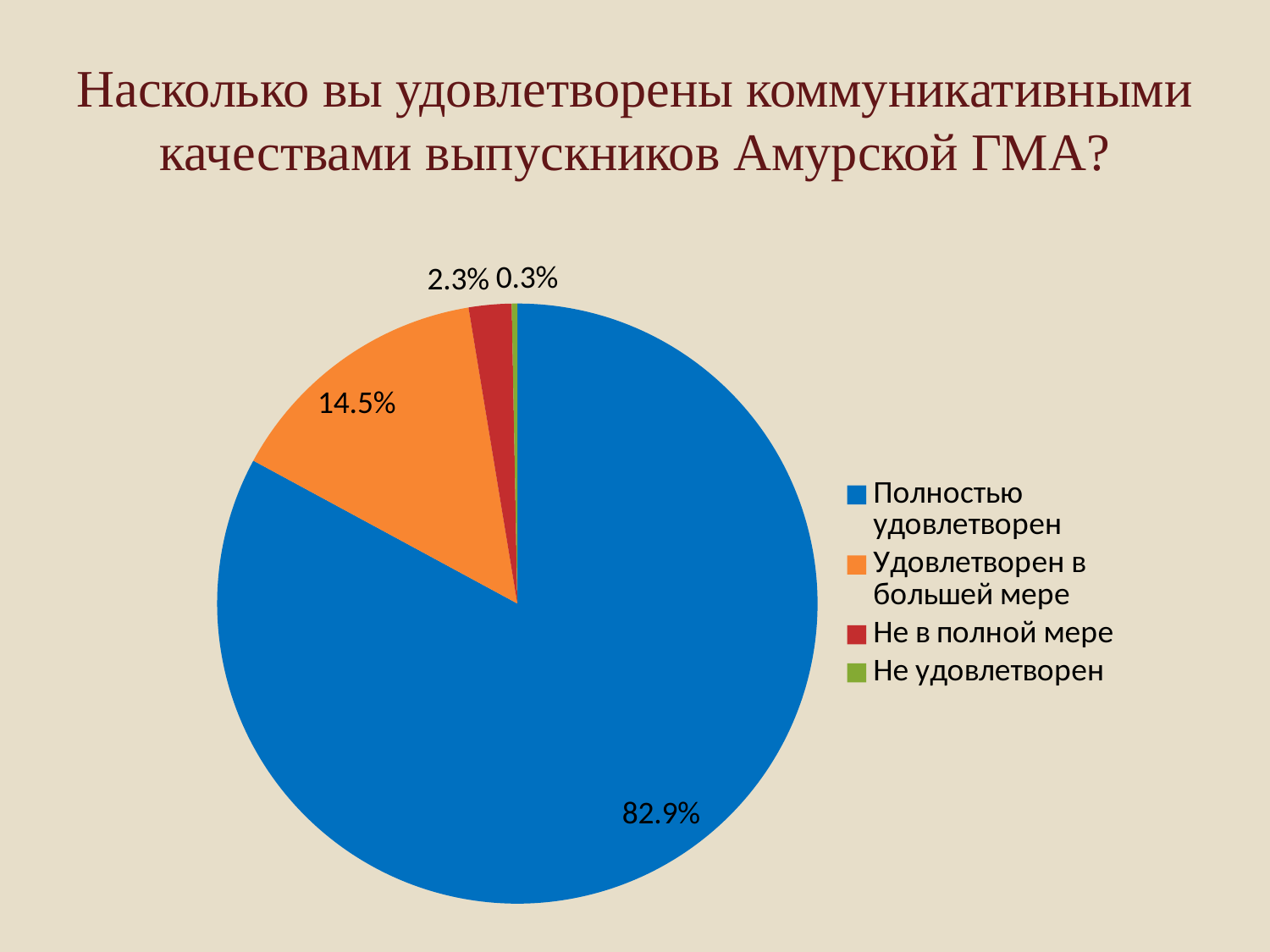
What colour is the slice for "Удовлетворен в большей мере"? Orange What share of respondents answered "Не удовлетворен"? 0.3% What share of respondents answered "Удовлетворен в большей мере"? 14.5% What kind of chart is shown on the slide? Pie chart Which is larger: the share for "Не в полной мере" or the share for "Не удовлетворен"? Не в полной мере How many categories does the pie chart have? 4 Which category has the largest slice of the pie? Полностью удовлетворен What share of respondents answered "Не в полной мере"? 2.3% Which category has the smallest slice of the pie? Не удовлетворен What is the title of the slide containing the chart? Насколько вы удовлетворены коммуникативными качествами выпускников Амурской ГМА? What is the difference between the shares for "Полностью удовлетворен" and "Удовлетворен в большей мере"? 68.4% What share of respondents answered "Полностью удовлетворен"? 82.9%